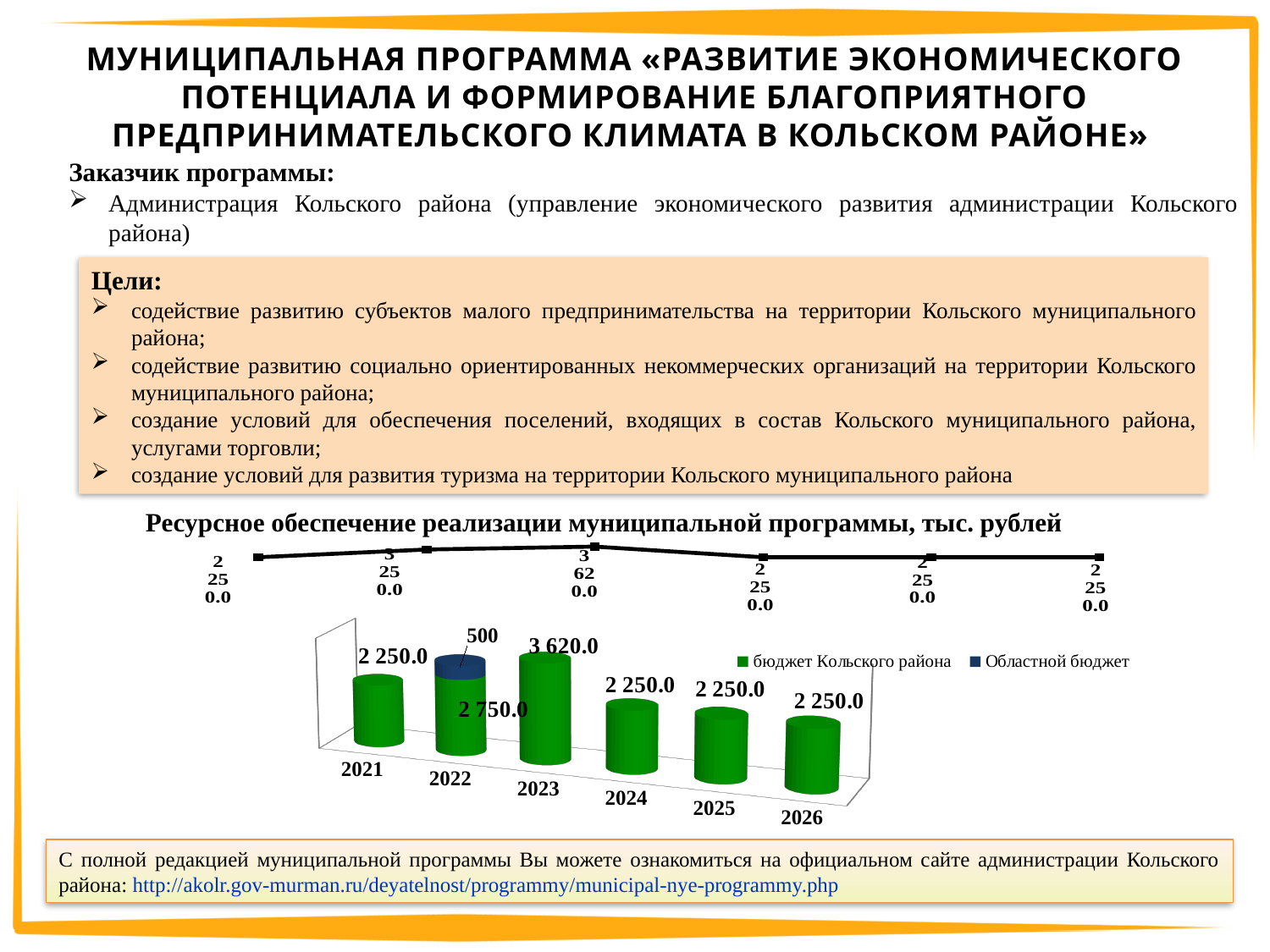
What kind of chart is shown under the heading «Ресурсное обеспечение реализации муниципальной программы, тыс. рублей»? bar chart How many years are shown on the x axis of the chart? 6 What is the difference between the «бюджет Кольского района» values for 2023 and 2021? 1 370.0 What is the value of «бюджет Кольского района» for 2023? 3 620.0 Which year has the larger «бюджет Кольского района» value, 2022 or 2024? 2022 What is the value of «бюджет Кольского района» for 2026? 2 250.0 In which year is the value of «бюджет Кольского района» the highest? 2023 What is the value of «бюджет Кольского района» for 2021? 2 250.0 How many series does the chart legend list? 2 What is the value of «Областной бюджет» for 2022? 500 What is the total of the stacked bar for 2022 (both budgets combined)? 3 250.0 Which series is shown in green in the chart legend? бюджет Кольского района